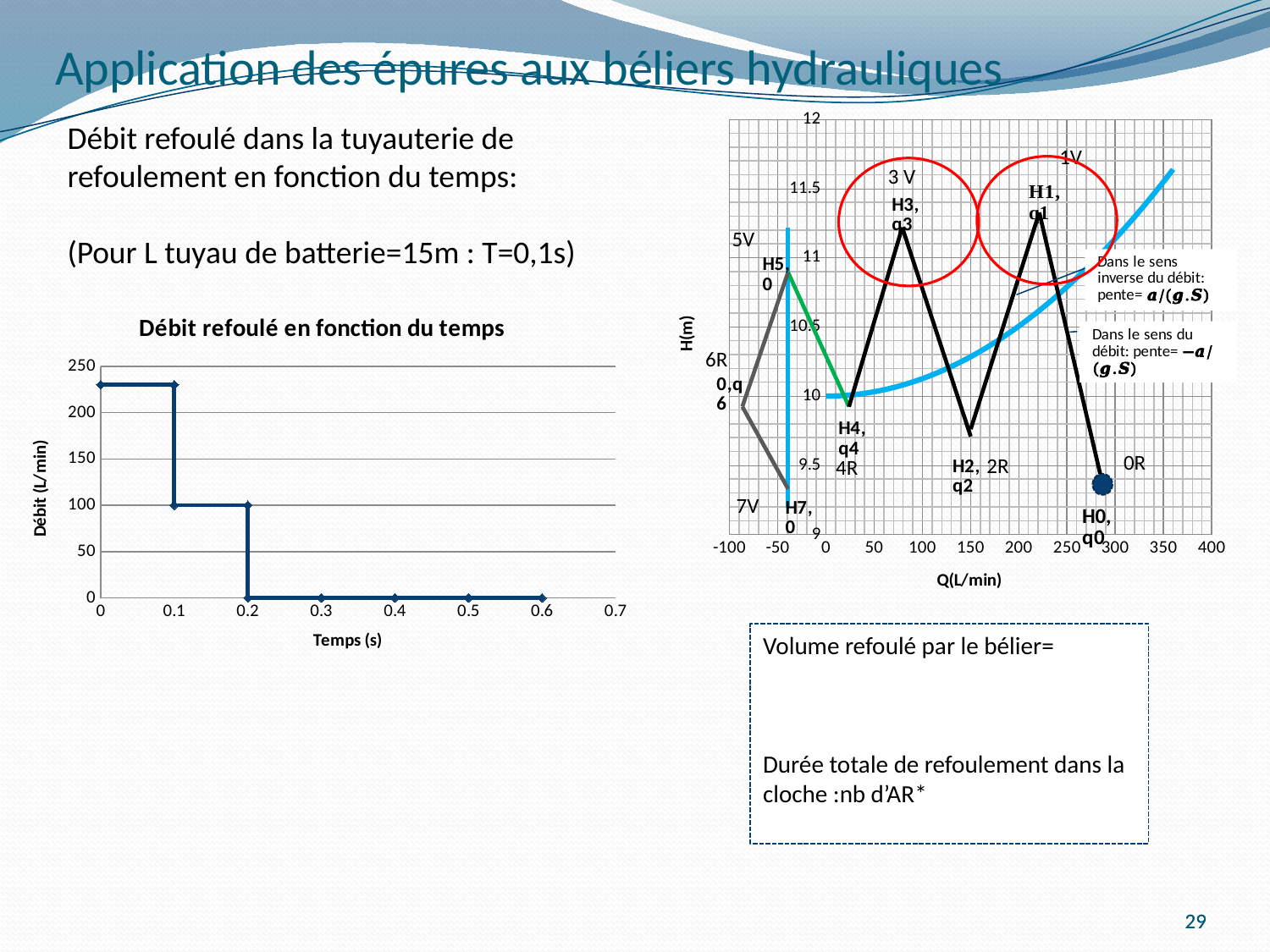
In the chart on the right with axes H(m) and Q(L/min), which point has the larger Q value, H1,q1 or H3,q3? H1,q1 In the chart on the right with axes H(m) and Q(L/min), what is the title of the x axis? Q(L/min) In the chart 'Débit refoulé en fonction du temps', what is the title of the x axis? Temps (s) In the chart on the right with axes H(m) and Q(L/min), is the Q value of point H0,q0 greater or less than 250? greater In the chart 'Débit refoulé en fonction du temps', what is the value of Débit at 0.3 s? 0 In the chart on the right with axes H(m) and Q(L/min), is the Q value of point H4,q4 greater or less than 50? less In the chart 'Débit refoulé en fonction du temps', is the value of Débit at 0 s greater or less than 200? greater In the chart 'Débit refoulé en fonction du temps', how many data points are plotted? 9 In the chart 'Débit refoulé en fonction du temps', what is the value of Débit between 0.1 s and 0.2 s? 100 In the chart 'Débit refoulé en fonction du temps', what is the value of Débit at 0.5 s? 0 In the chart 'Débit refoulé en fonction du temps', do the values rise or fall as time increases along the x axis? fall What kind of chart is the chart titled 'Débit refoulé en fonction du temps'? line chart